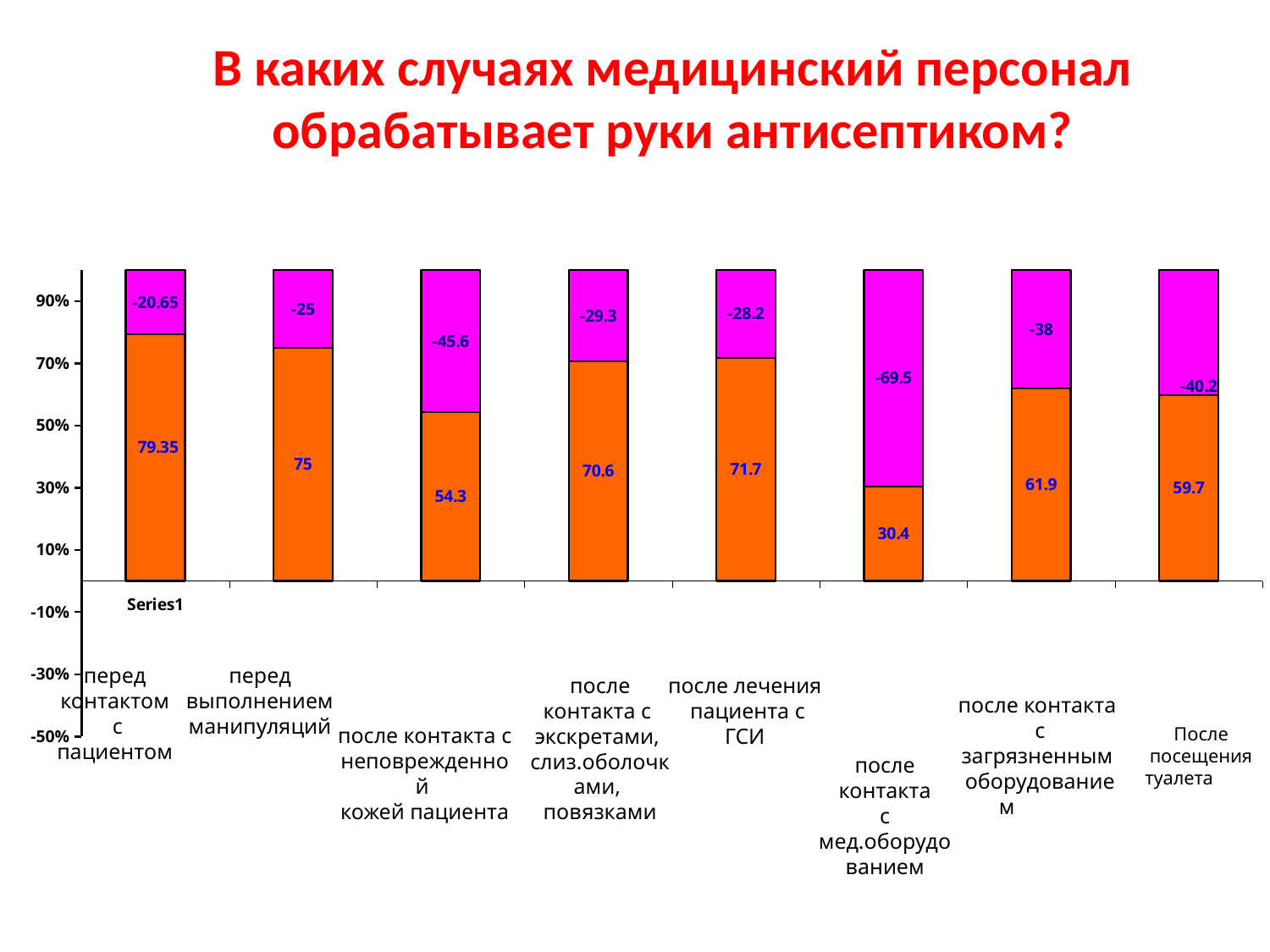
How many categories are shown on the chart? 8 What is the difference between the orange values for "перед выполнением манипуляций" and "после контакта с неповрежденной кожей пациента"? 20.7 What is the orange segment value for "После посещения туалета"? 59.7 What two colours are used for the bar segments in the chart? orange and magenta What is the magenta segment value for the category "после контакта с мед.оборудованием"? -69.5 What is the orange segment value for the category "перед контактом с пациентом"? 79.35 Which category has the lowest orange segment value? после контакта с мед.оборудованием What type of chart is shown on the slide? stacked bar chart What is the magenta segment value for "после контакта с загрязненным оборудованием"? -38 Which has a larger orange segment value: "после лечения пациента с ГСИ" or "после контакта с экскретами, слиз.оболочками, повязками"? после лечения пациента с ГСИ Which category has the highest orange segment value? перед контактом с пациентом What is the title of the slide? В каких случаях медицинский персонал обрабатывает руки антисептиком?